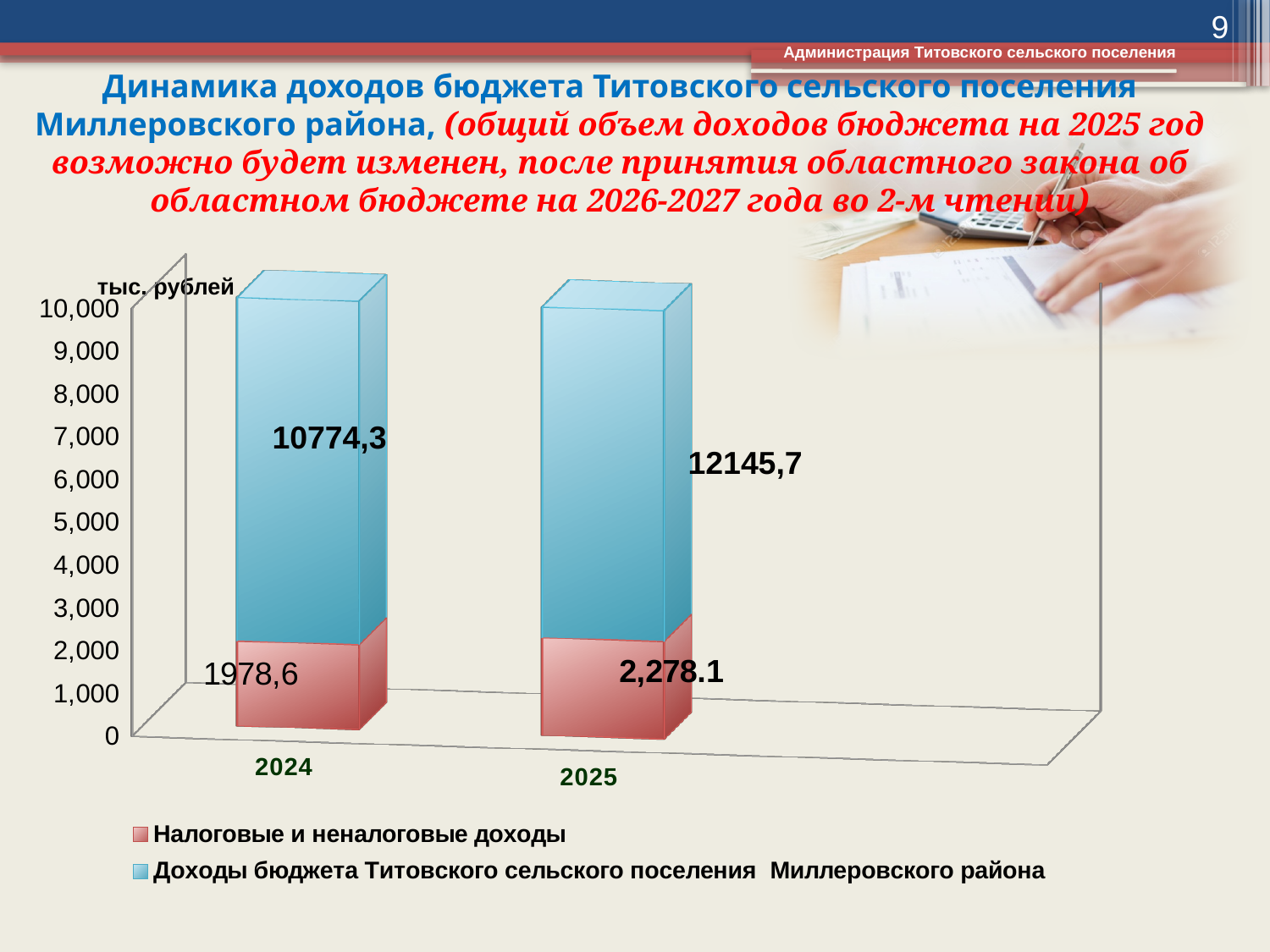
Is the top of the blue bar for 2025 greater or less than 10,000? greater What kind of chart is shown on the slide? bar chart Which year has the higher value for Доходы бюджета Титовского сельского поселения Миллеровского района, 2024 or 2025? 2025 What is the value labelled on the red bar (Налоговые и неналоговые доходы) for 2024? 1978,6 What is the value labelled on the red bar (Налоговые и неналоговые доходы) for 2025? 2,278.1 By how much does the blue-bar value for 2025 exceed the blue-bar value for 2024? 1371,4 How many years (categories) are shown on the x axis? 2 Which year has the lower value for Налоговые и неналоговые доходы? 2024 What is the value labelled on the blue bar for 2025? 12145,7 What unit is indicated at the top of the vertical axis? тыс. рублей What is the value labelled on the blue bar for 2024? 10774,3 How many series does the legend list? 2